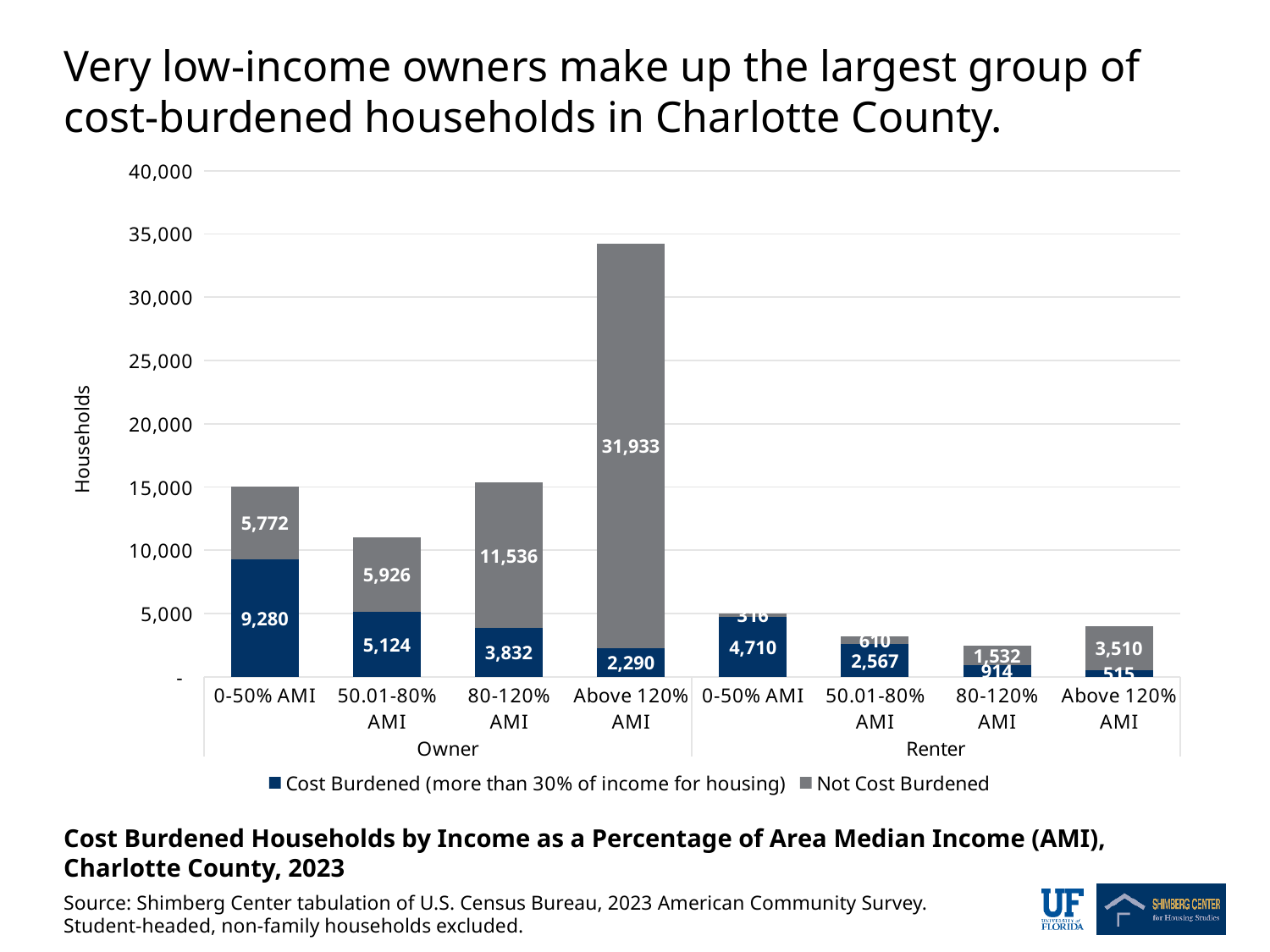
Is the total height of the Owner Above 120% AMI bar greater or less than 30,000? greater What is the number of not cost-burdened renter households in the 80-120% AMI group? 1,532 How many series does the legend list? 2 What is the number of cost-burdened owner households in the 0-50% AMI group? 9,280 Which has more not cost-burdened owner households: the 80-120% AMI group or the 50.01-80% AMI group? 80-120% AMI What is the number of not cost-burdened owner households in the Above 120% AMI group? 31,933 Do the cost-burdened owner household values rise or fall as income group increases from 0-50% AMI to Above 120% AMI? fall Which owner income group has the lowest number of cost-burdened households? Above 120% AMI Which owner income group has the highest number of cost-burdened households? 0-50% AMI What is the total number of owner households in the 0-50% AMI group (cost burdened plus not cost burdened)? 15,052 What is the difference between cost-burdened owner households in the 0-50% AMI group and the 50.01-80% AMI group? 4,156 What kind of chart is shown on the slide? Stacked bar chart